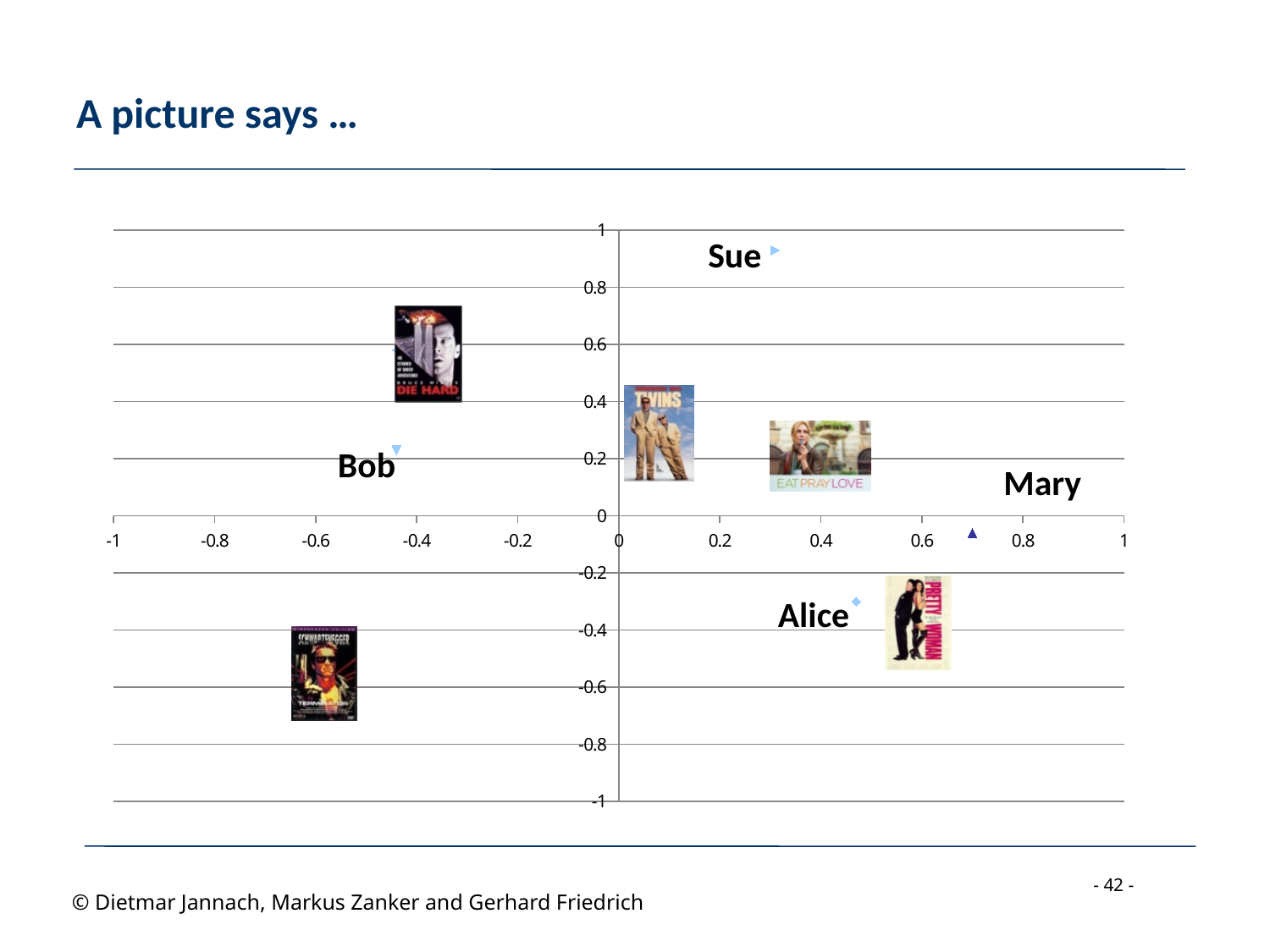
Which user has the highest value on the horizontal axis? Mary What is the title of the slide containing the chart? A picture says … Which user has the lowest value on the horizontal axis? Bob Who has the larger value on the vertical axis, Sue or Alice? Sue Is Alice's value on the vertical axis greater or less than -0.2? less Is Sue's value on the vertical axis greater or less than 0.8? greater What kind of chart is shown on the slide? scatter chart How many named users are plotted as points on the chart? 4 Which user has the lowest value on the vertical axis? Alice Which user has the highest value on the vertical axis? Sue Is Mary's value on the horizontal axis greater or less than 0.6? greater